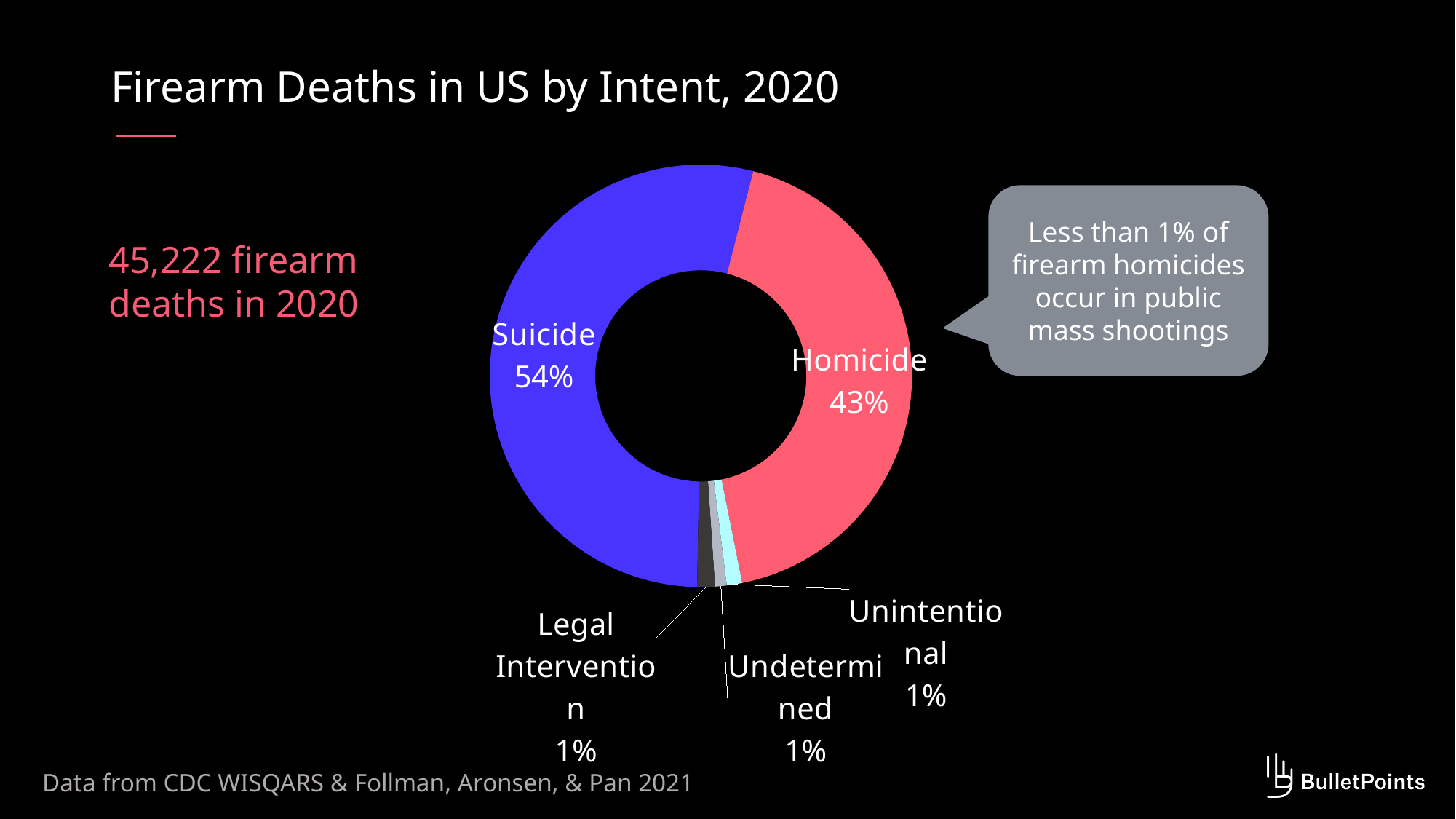
What percentage is shown for Unintentional firearm deaths? 1% Which intent category accounts for the largest share of firearm deaths in the chart? Suicide What kind of chart is used on this slide? Doughnut (pie) chart Which is larger, the share for Suicide or the share for Homicide? Suicide What colour is the Suicide segment of the chart? Blue What percentage of firearm deaths in 2020 were suicides according to the chart? 54% What percentage is shown for Legal Intervention? 1% What is the title of the chart on this slide? Firearm Deaths in US by Intent, 2020 What share of the doughnut chart is labelled Homicide? 43% By how many percentage points does the Suicide share exceed the Homicide share? 11 percentage points How many intent categories are shown in the chart? 5 Is the share for Homicide greater or less than 50%? less